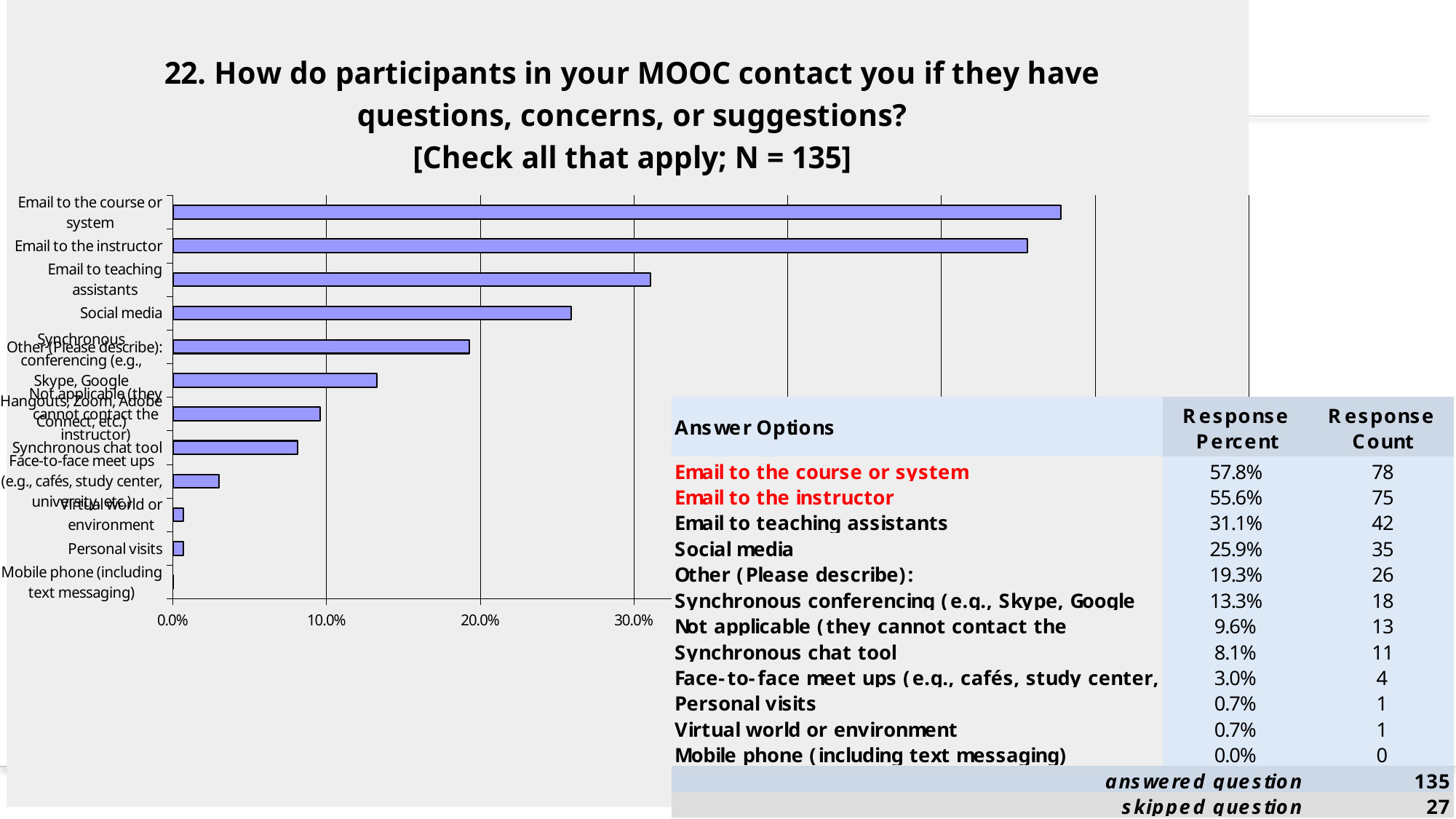
Which is larger, the response percent for Email to teaching assistants or for Social media? Email to teaching assistants What is the response count for Social media? 35 What is the difference in response percent between Email to the course or system and Email to the instructor? 2.2% Is the value for Other (Please describe) greater or less than 20.0%? less Which contact method has the highest response percent? Email to the course or system What is the response percent for Email to the instructor? 55.6% What kind of chart is shown on the slide? bar chart What is the difference in response count between Email to teaching assistants and Social media? 7 Which contact method has the lowest response percent? Mobile phone (including text messaging) How many respondents answered the question according to the table? 135 What is the response percent for Synchronous chat tool? 8.1% How many contact methods (categories) are plotted in the chart? 12